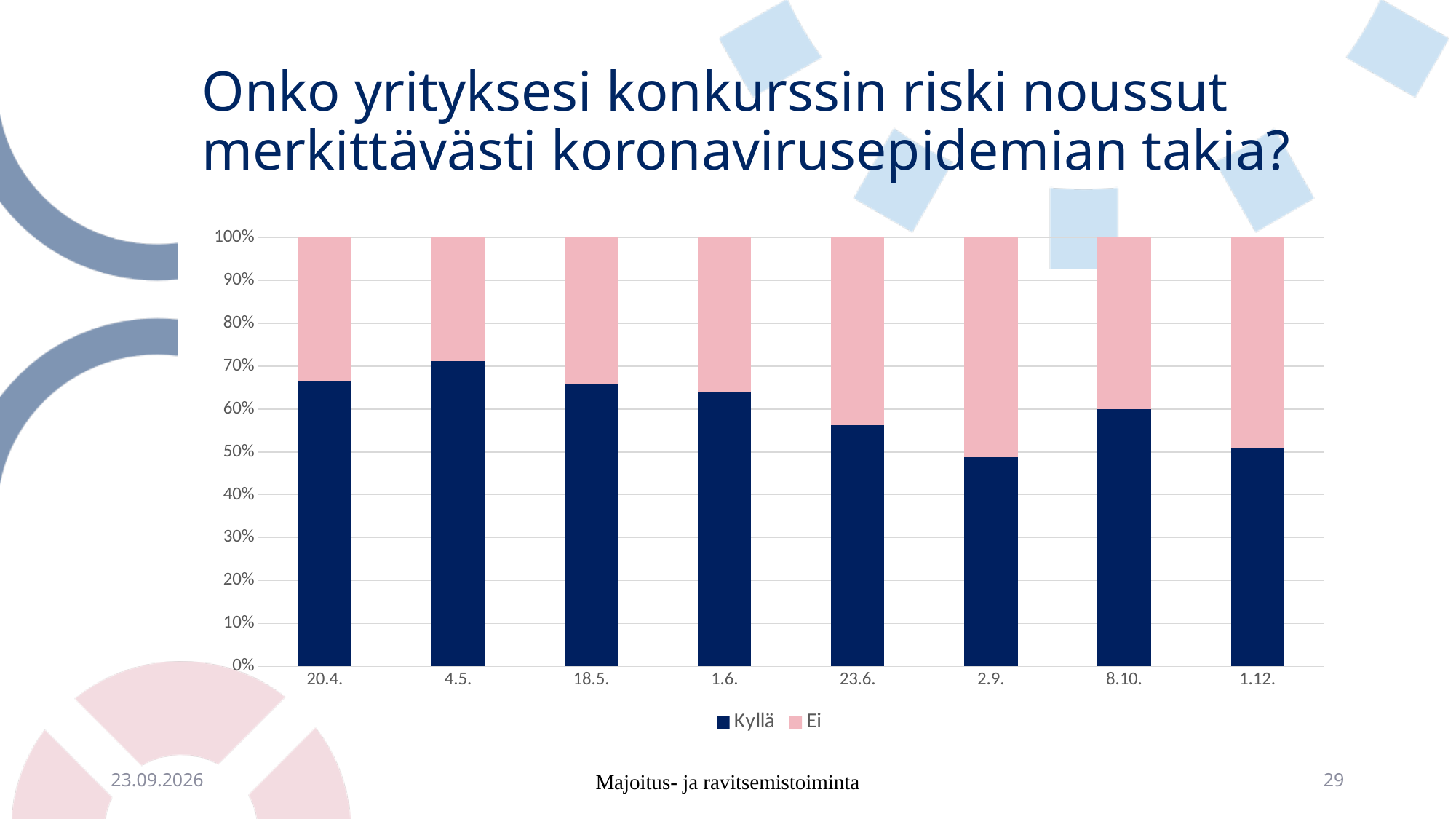
Which date has the lowest share of Kyllä? 2.9. Which colour represents the Ei series? Pink Which date has the highest share of Kyllä? 4.5. What kind of chart is shown on the slide? Stacked bar chart Is the Kyllä share for 20.4. greater or less than 70%? less How many series does the legend list? 2 Which has a larger Kyllä share, 4.5. or 2.9.? 4.5. Is the Kyllä share for 1.6. greater or less than 60%? greater How many dates (categories) are shown on the x axis? 8 Which has a larger Ei share, 2.9. or 20.4.? 2.9. Is the Kyllä share for 23.6. greater or less than 50%? greater Does the Kyllä share rise or fall from 4.5. to 2.9.? fall